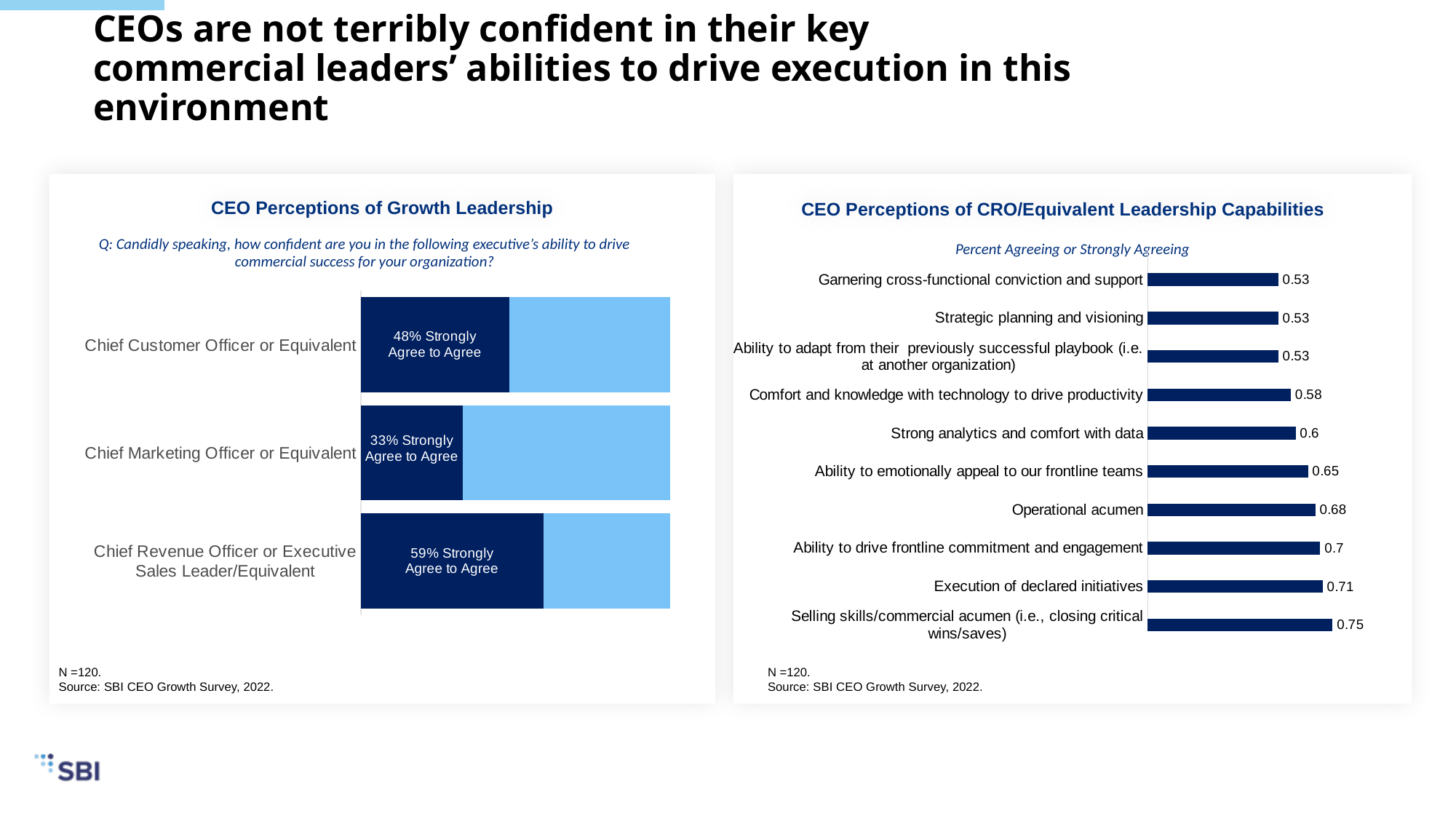
In the 'CEO Perceptions of Growth Leadership' chart, what is the difference between the Chief Revenue Officer and Chief Marketing Officer percentages? 26% In the 'CEO Perceptions of Growth Leadership' chart, what percentage of CEOs strongly agree to agree for the Chief Customer Officer or Equivalent? 48% In the 'CEO Perceptions of CRO/Equivalent Leadership Capabilities' chart, what is the value for Operational acumen? 0.68 In the 'CEO Perceptions of CRO/Equivalent Leadership Capabilities' chart, what is the difference between Execution of declared initiatives and Comfort and knowledge with technology to drive productivity? 0.13 In the 'CEO Perceptions of CRO/Equivalent Leadership Capabilities' chart, which is larger: Ability to emotionally appeal to our frontline teams or Strategic planning and visioning? Ability to emotionally appeal to our frontline teams How many capabilities are listed in the 'CEO Perceptions of CRO/Equivalent Leadership Capabilities' chart? 10 In the 'CEO Perceptions of CRO/Equivalent Leadership Capabilities' chart, which capability has the highest value? Selling skills/commercial acumen (i.e., closing critical wins/saves) How many executive categories are shown in the 'CEO Perceptions of Growth Leadership' chart? 3 In the 'CEO Perceptions of Growth Leadership' chart, which executive has the highest percentage of CEOs strongly agreeing to agreeing? Chief Revenue Officer or Executive Sales Leader/Equivalent In the 'CEO Perceptions of Growth Leadership' chart, what percentage is shown for the Chief Marketing Officer or Equivalent? 33% In the 'CEO Perceptions of Growth Leadership' chart, which executive has the lowest percentage? Chief Marketing Officer or Equivalent In the 'CEO Perceptions of CRO/Equivalent Leadership Capabilities' chart, what is the value for Strong analytics and comfort with data? 0.6